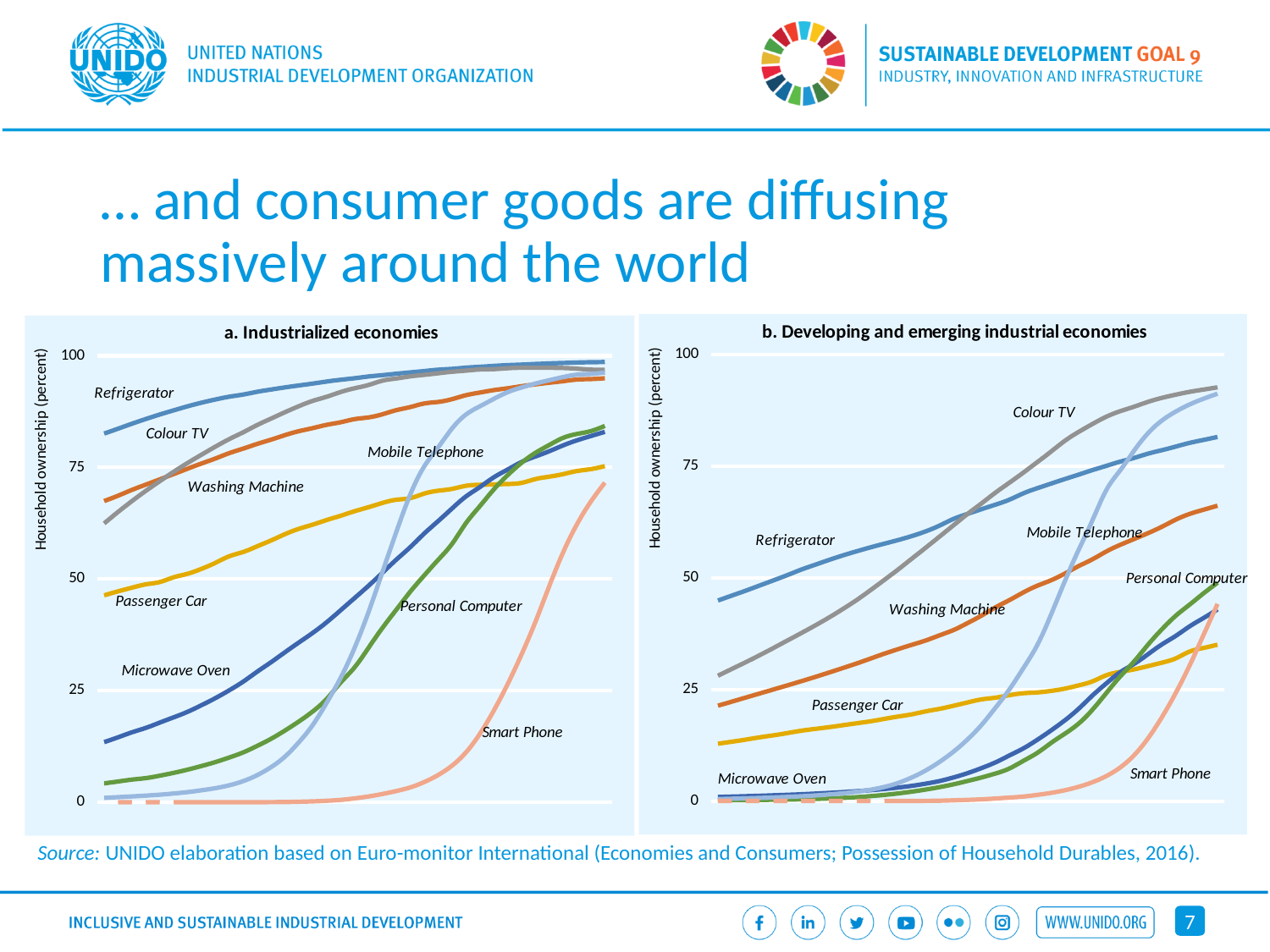
How many series (lines) are plotted in the chart 'b. Developing and emerging industrial economies'? 8 What is the y-axis label of the chart 'a. Industrialized economies'? Household ownership (percent) In the chart 'a. Industrialized economies', is the final value for Smart Phone greater or less than 75? less In the chart 'a. Industrialized economies', is the starting value for Refrigerator greater or less than 75? greater In the chart 'b. Developing and emerging industrial economies', is the final value for Colour TV greater or less than 75? greater In the chart 'a. Industrialized economies', which series has the highest value at the start of the period? Refrigerator What kind of chart is the left chart, 'a. Industrialized economies'? line chart In the chart 'b. Developing and emerging industrial economies', which series has the highest value at the start of the period? Refrigerator In the chart 'b. Developing and emerging industrial economies', does the Colour TV line rise or fall along the x axis? rise In the chart 'a. Industrialized economies', which is larger at the end of the period: Personal Computer or Smart Phone? Personal Computer